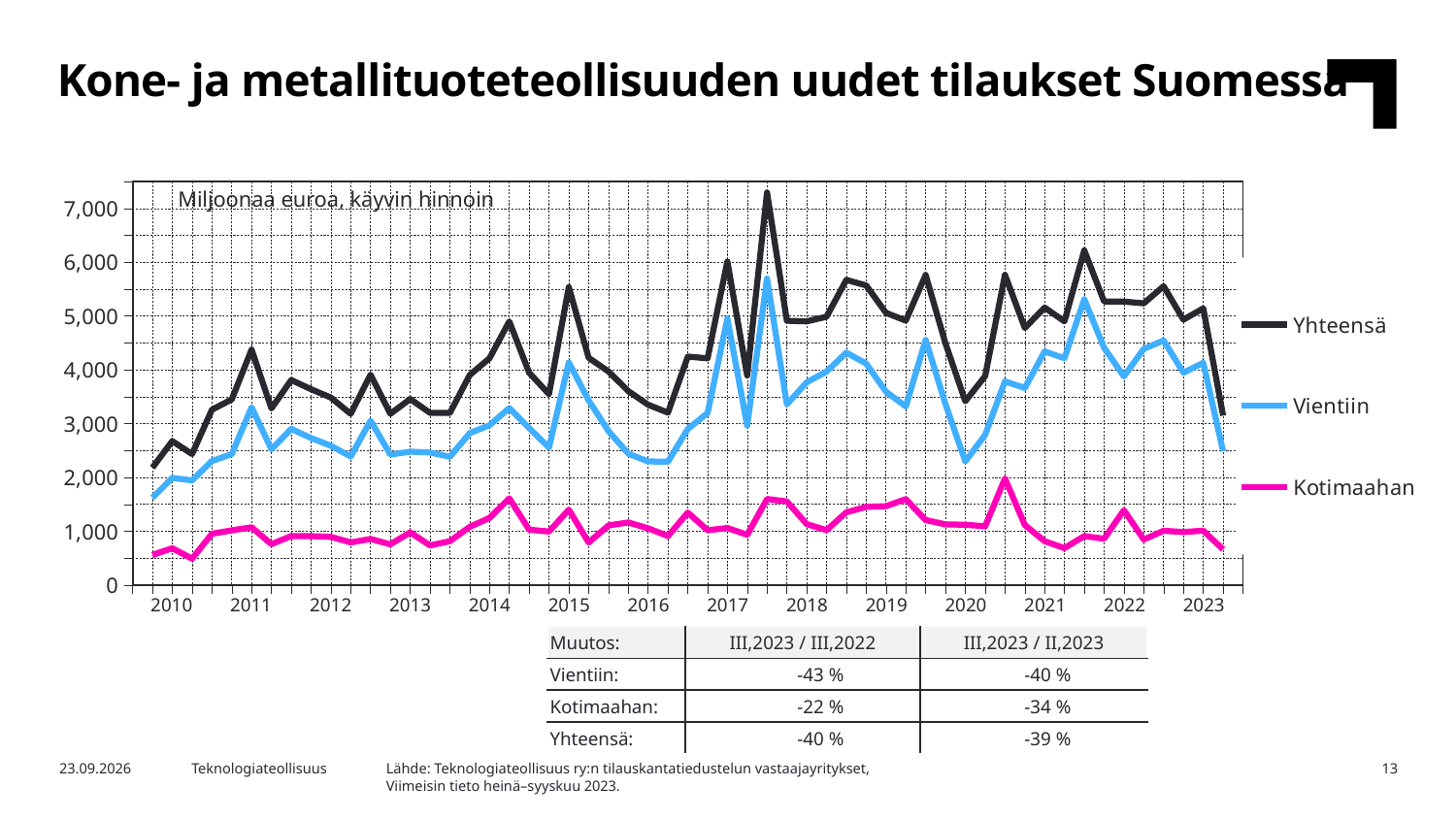
Is the highest peak of the Vientiin line greater or less than 5,000? greater How many series does the chart legend list? 3 What kind of chart is shown on the slide? line chart How many years are labelled on the x axis of the chart? 14 In which year does the Yhteensä line reach its highest peak? 2017 What are the three series named in the chart legend? Yhteensä, Vientiin, Kotimaahan Is the highest peak of the Yhteensä line greater or less than 7,000? greater Is the first value of the Kotimaahan line in 2010 greater or less than 1,000? less Which series has the lowest values throughout the chart? Kotimaahan Which series has the highest values throughout the chart? Yhteensä What unit is stated in the label inside the chart area? Miljoonaa euroa, käyvin hinnoin